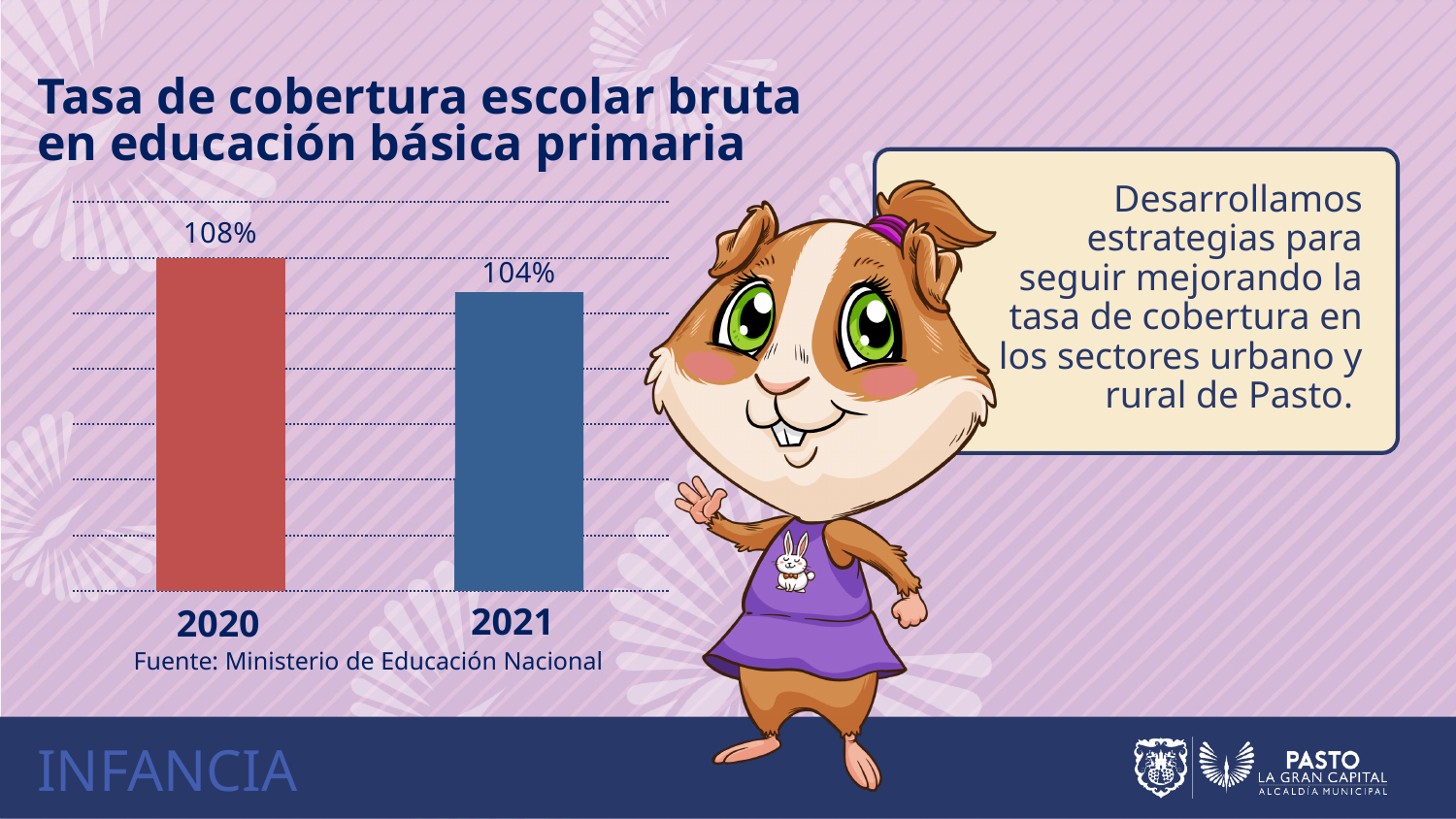
What colour is the bar for 2021? blue By how many percentage points does the 2020 value exceed the 2021 value? 4 percentage points How many years (categories) are plotted in the chart? 2 What kind of chart is shown on the slide? bar chart Which year has the higher coverage rate? 2020 What is the title of the chart? Tasa de cobertura escolar bruta en educación básica primaria Is the value for 2020 larger or smaller than the value for 2021? larger What is the gross school coverage rate shown for 2021? 104% Does the coverage rate rise or fall from 2020 to 2021? fall Which year has the lower coverage rate? 2021 What is the gross school coverage rate shown for 2020? 108%